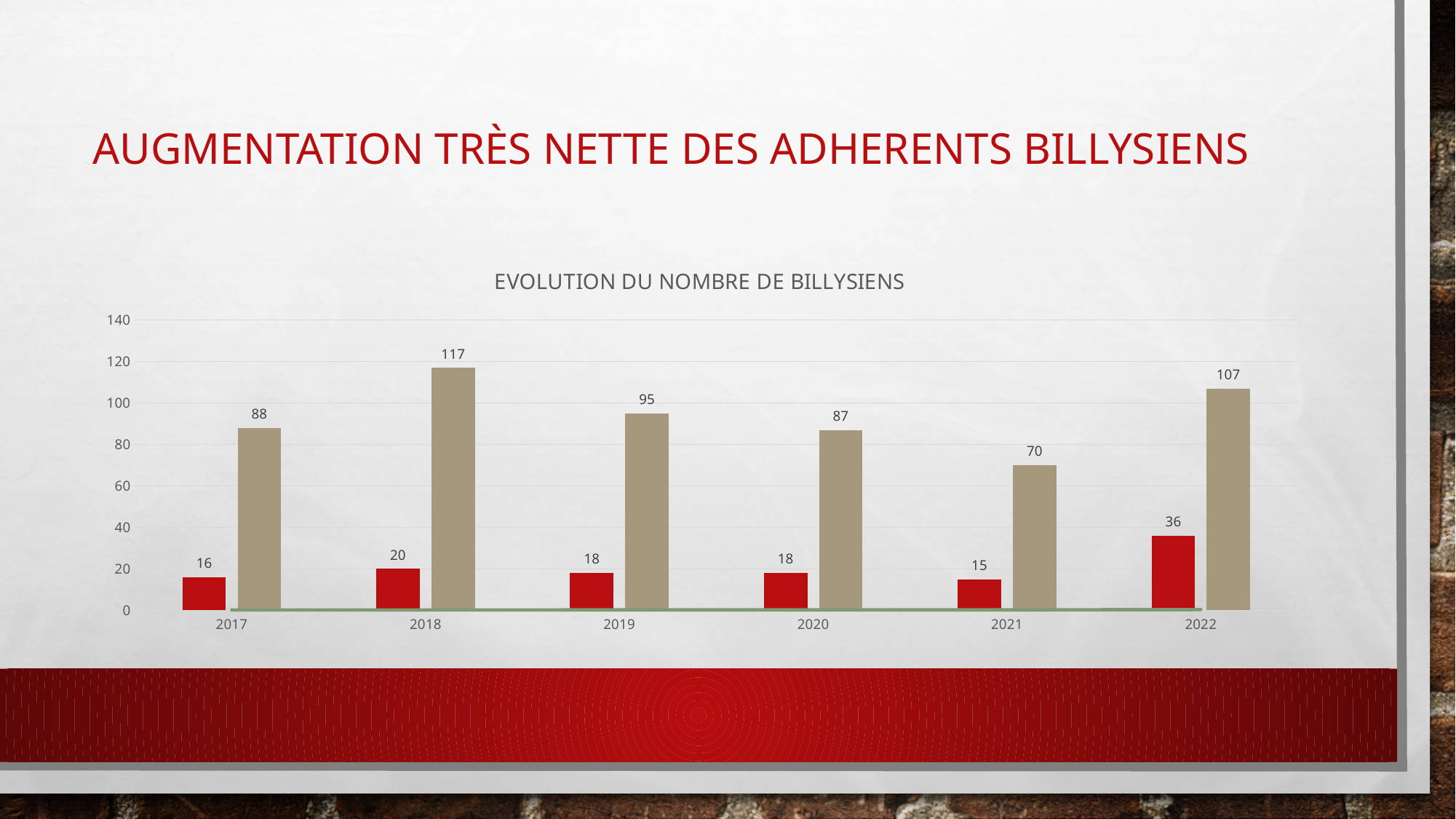
Is the value of the tan bar for 2022 greater or less than 100? greater In which year is the red bar lowest? 2021 Which is larger, the tan bar for 2019 or the tan bar for 2020? 2019 What is the title of the chart? EVOLUTION DU NOMBRE DE BILLYSIENS What kind of chart is shown on the slide? Bar chart How many years are shown on the x axis? 6 What is the value of the tan bar for 2021? 70 What is the difference between the tan bar and the red bar in 2022? 71 What is the value of the red bar for 2022? 36 What is the value of the tan bar for 2018? 117 In which year is the tan bar highest? 2018 What is the value of the red bar for 2017? 16